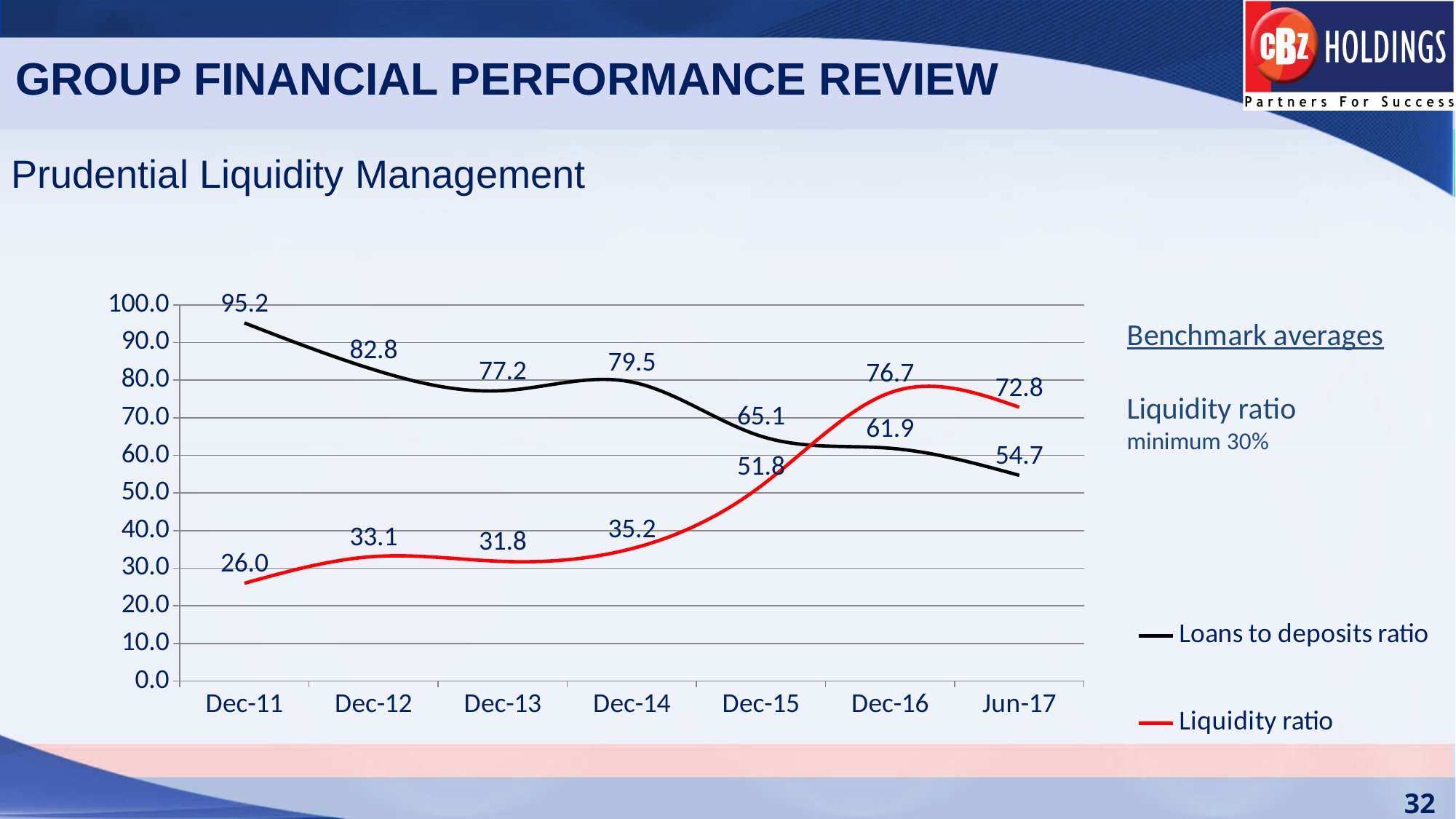
What is the Liquidity ratio at Jun-17? 72.8 At which date is the Loans to deposits ratio lowest? Jun-17 What is the Loans to deposits ratio at Dec-11? 95.2 What is the Loans to deposits ratio at Dec-16? 61.9 Which is larger at Dec-16: the Liquidity ratio or the Loans to deposits ratio? Liquidity ratio At which date is the Liquidity ratio highest? Dec-16 What is the difference between the Loans to deposits ratio at Dec-11 and at Jun-17? 40.5 Does the Liquidity ratio rise or fall from Dec-14 to Dec-16? Rise How many series does the legend list? 2 What kind of chart is shown on the slide? Line chart What is the Liquidity ratio at Dec-14? 35.2 How many dates are shown on the x axis? 7